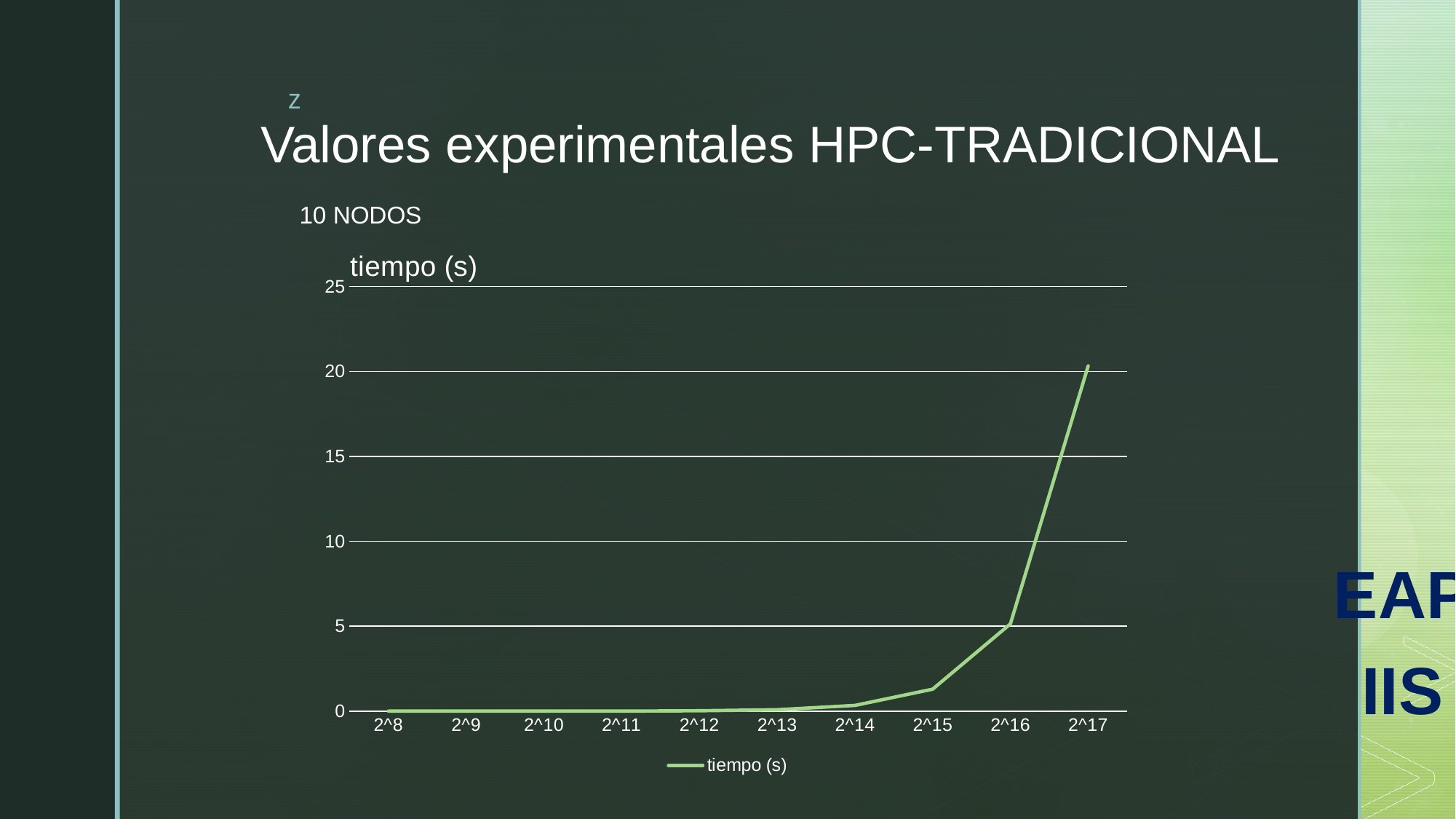
Do the values rise or fall as the x axis goes from 2^8 to 2^17? rise Which category has the highest value for tiempo (s)? 2^17 Is the value for 2^16 greater or less than 10? less Which has a larger value, 2^16 or 2^17? 2^17 What is the title of the chart? tiempo (s) Is the value for 2^14 greater or less than 5? less How many series does the legend list? 1 Is the value for 2^15 greater or less than 5? less What is the label of the series shown in the legend? tiempo (s) What kind of chart is shown on the slide? line chart How many categories are plotted along the x axis? 10